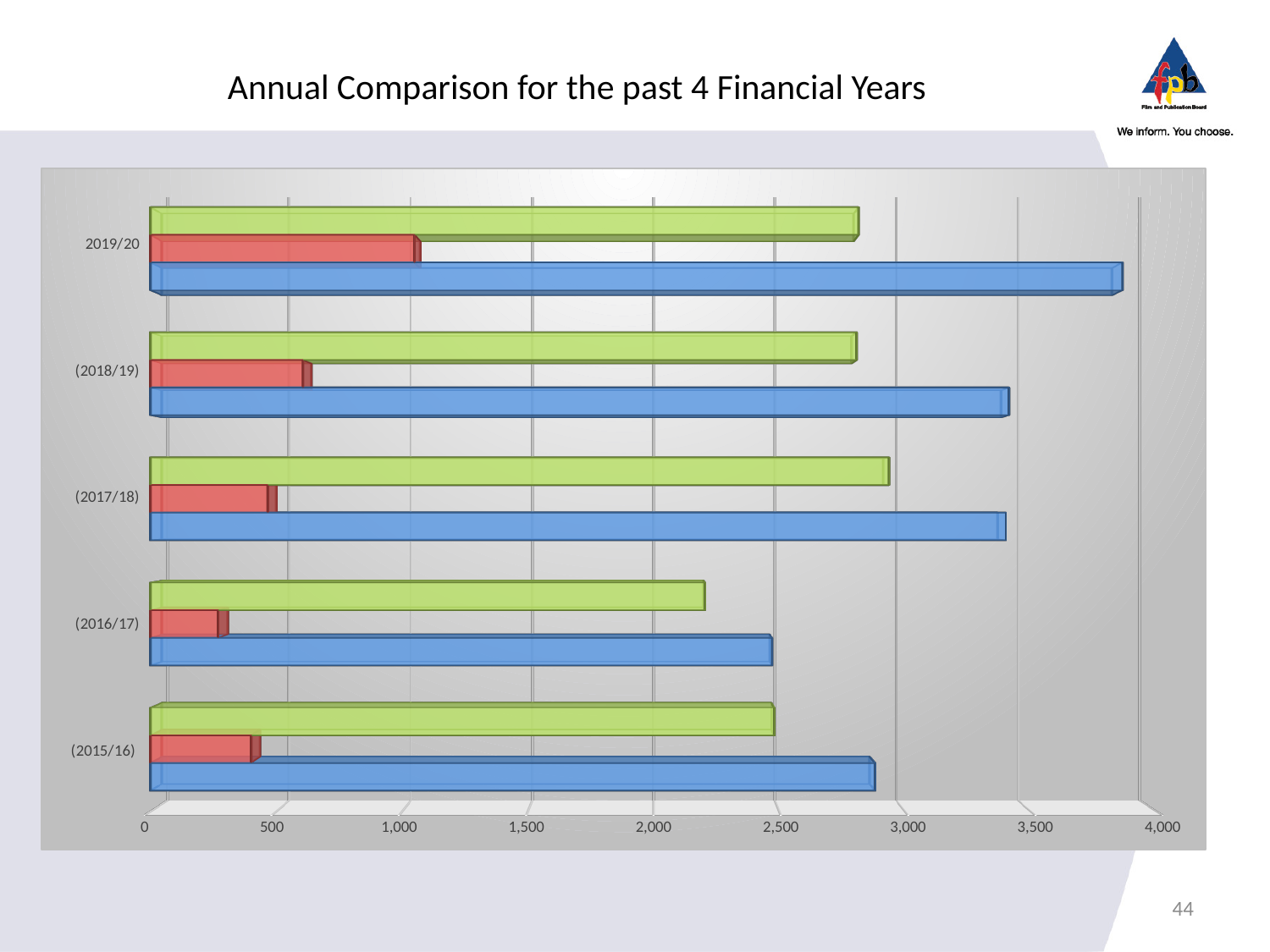
Which financial year has the shortest green bar? (2016/17) How many financial year categories are shown on the chart? 5 What is the title of the chart? Annual Comparison for the past 4 Financial Years Which financial year has the longest blue bar? 2019/20 What kind of chart is shown on the slide? bar chart For 2019/20, which is larger: the blue bar or the green bar? the blue bar Is the value of the green bar for (2016/17) greater or less than 2,500? less Is the value of the blue bar for 2019/20 greater or less than 3,500? greater Which financial year has the shortest red bar? (2016/17) For (2015/16), which is larger: the red bar or the green bar? the green bar How many bars are plotted for each financial year category? 3 Is the value of the red bar for (2018/19) greater or less than 500? greater